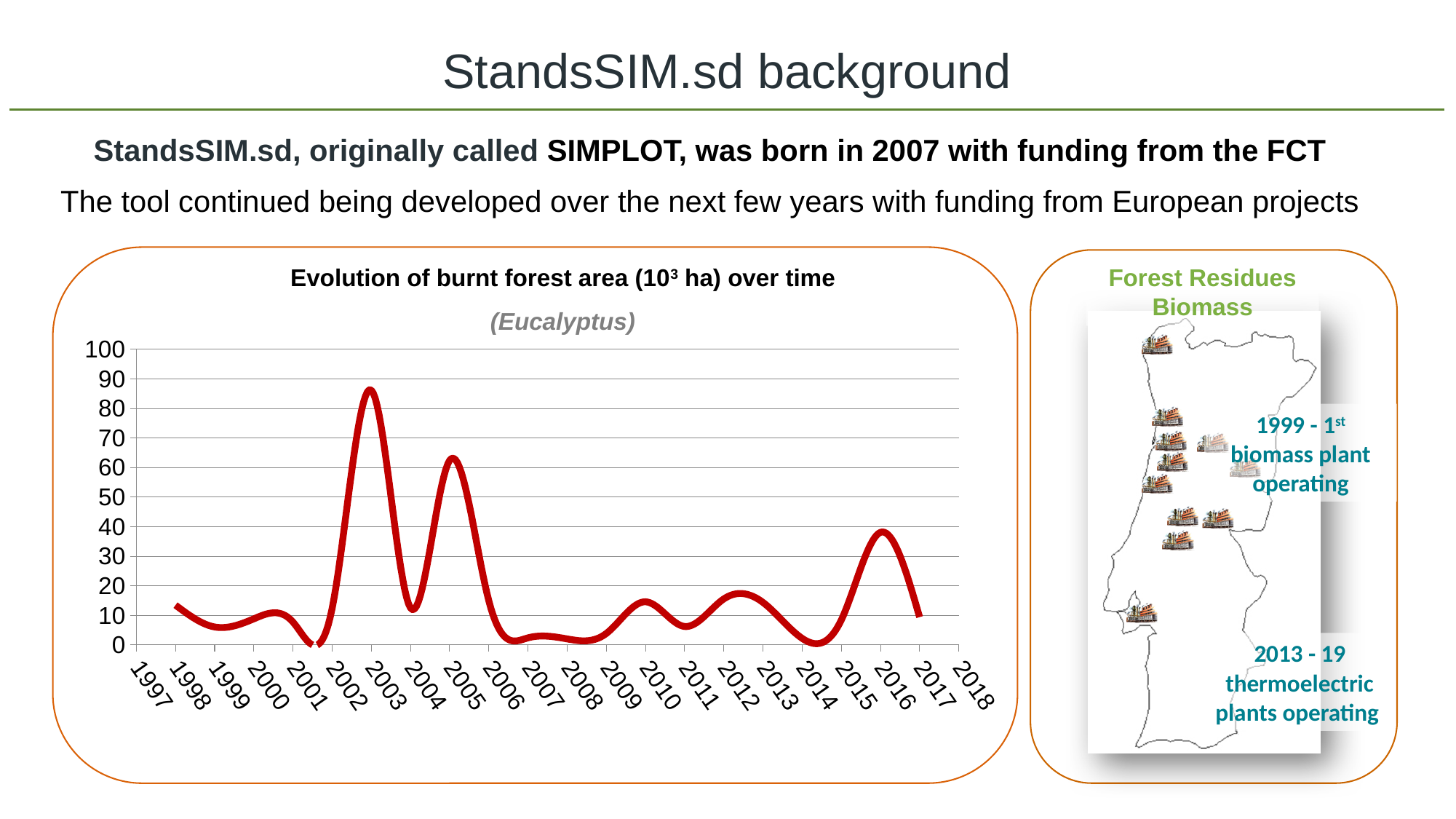
Is the value for 2014 greater or less than 10? less What is the title of the chart? Evolution of burnt forest area (10³ ha) over time Which year has the larger burnt forest area, 2005 or 2016? 2005 Is the value for 2016 greater or less than 30? greater Is the value for 2007 greater or less than 10? less What kind of chart is shown on the slide? line chart Which year has the larger burnt forest area, 2003 or 2005? 2003 Does the burnt forest area rise or fall between 2005 and 2007? fall In which year does the burnt forest area reach its highest value? 2003 Which tree species does the chart subtitle refer to? Eucalyptus